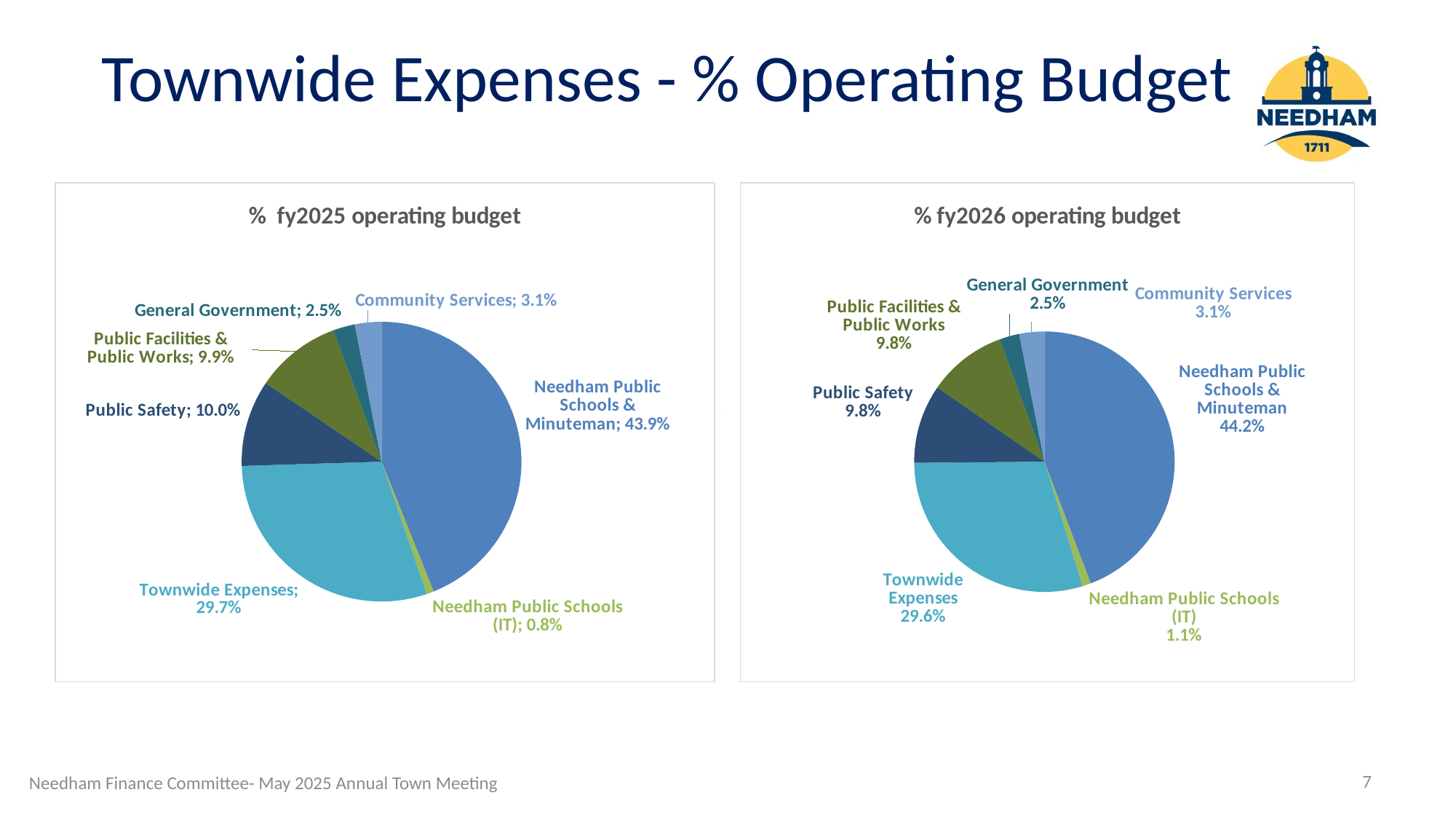
How many categories are shown in the '% fy2025 operating budget' pie chart? 7 What is the title of the chart on the left side of the slide? % fy2025 operating budget In the '% fy2025 operating budget' chart, what share of the budget is Townwide Expenses? 29.7% In the '% fy2026 operating budget' chart, which category has the smallest share? Needham Public Schools (IT) In the '% fy2025 operating budget' chart, which category has the largest share? Needham Public Schools & Minuteman In the '% fy2025 operating budget' chart, what is the value for Needham Public Schools (IT)? 0.8% In the '% fy2025 operating budget' chart, what is the difference between Public Safety and Public Facilities & Public Works? 0.1% What type of chart is the '% fy2026 operating budget' chart? Pie chart In the '% fy2026 operating budget' chart, what is the value for Community Services? 3.1% In the '% fy2026 operating budget' chart, what share of the budget is Needham Public Schools & Minuteman? 44.2% In the '% fy2026 operating budget' chart, what is the value for Public Safety? 9.8% In the '% fy2026 operating budget' chart, which is larger: Townwide Expenses or Public Safety? Townwide Expenses